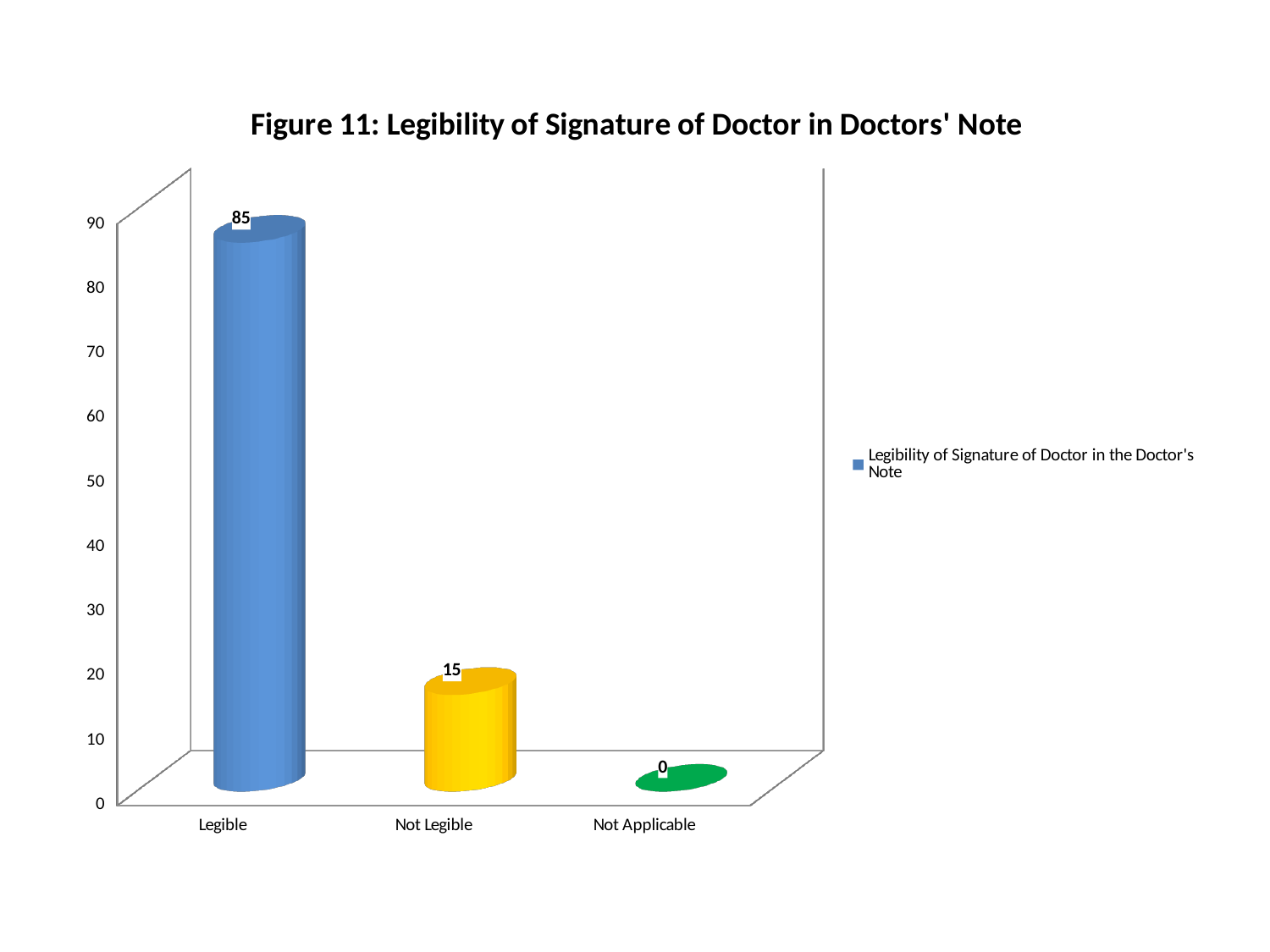
Which is larger, the value for Not Legible or the value for Not Applicable? Not Legible What kind of chart is shown on the slide? bar chart What is the value for Not Applicable? 0 How many categories are shown on the x axis? 3 What is the value for Legible? 85 Is the value for Legible greater or less than 80? greater Which category has the highest value? Legible What is the value for Not Legible? 15 Which category has the lowest value? Not Applicable How many series does the legend list? 1 What is the difference between the values for Legible and Not Legible? 70 What is the title of the chart? Figure 11: Legibility of Signature of Doctor in Doctors' Note